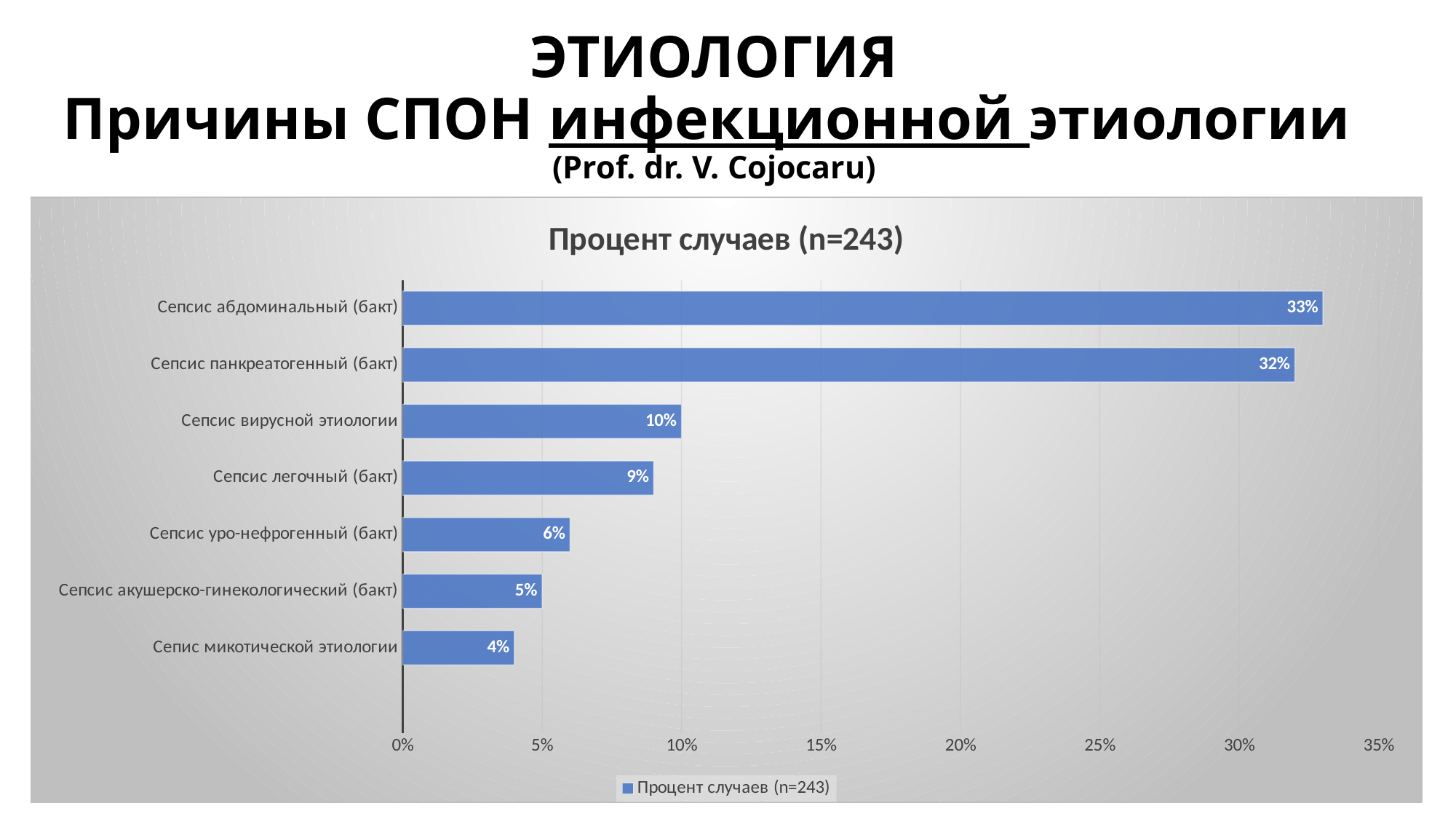
What is the value for Сепсис акушерско-гинекологический (бакт)? 5% How many categories are shown in the chart? 7 What kind of chart is shown on the slide? bar chart What is the value for Сепсис вирусной этиологии? 10% Is the value for Сепсис панкреатогенный (бакт) greater or less than 30%? greater How many series does the legend list? 1 Which is larger: the value for Сепсис уро-нефрогенный (бакт) or the value for Сепсис легочный (бакт)? Сепсис легочный (бакт) What is the value for Сепсис абдоминальный (бакт)? 33% Which category has the highest value? Сепсис абдоминальный (бакт) What is the title of the chart? Процент случаев (n=243) Which category has the lowest value? Сепис микотической этиологии What is the difference between the values for Сепсис панкреатогенный (бакт) and Сепсис легочный (бакт)? 23%